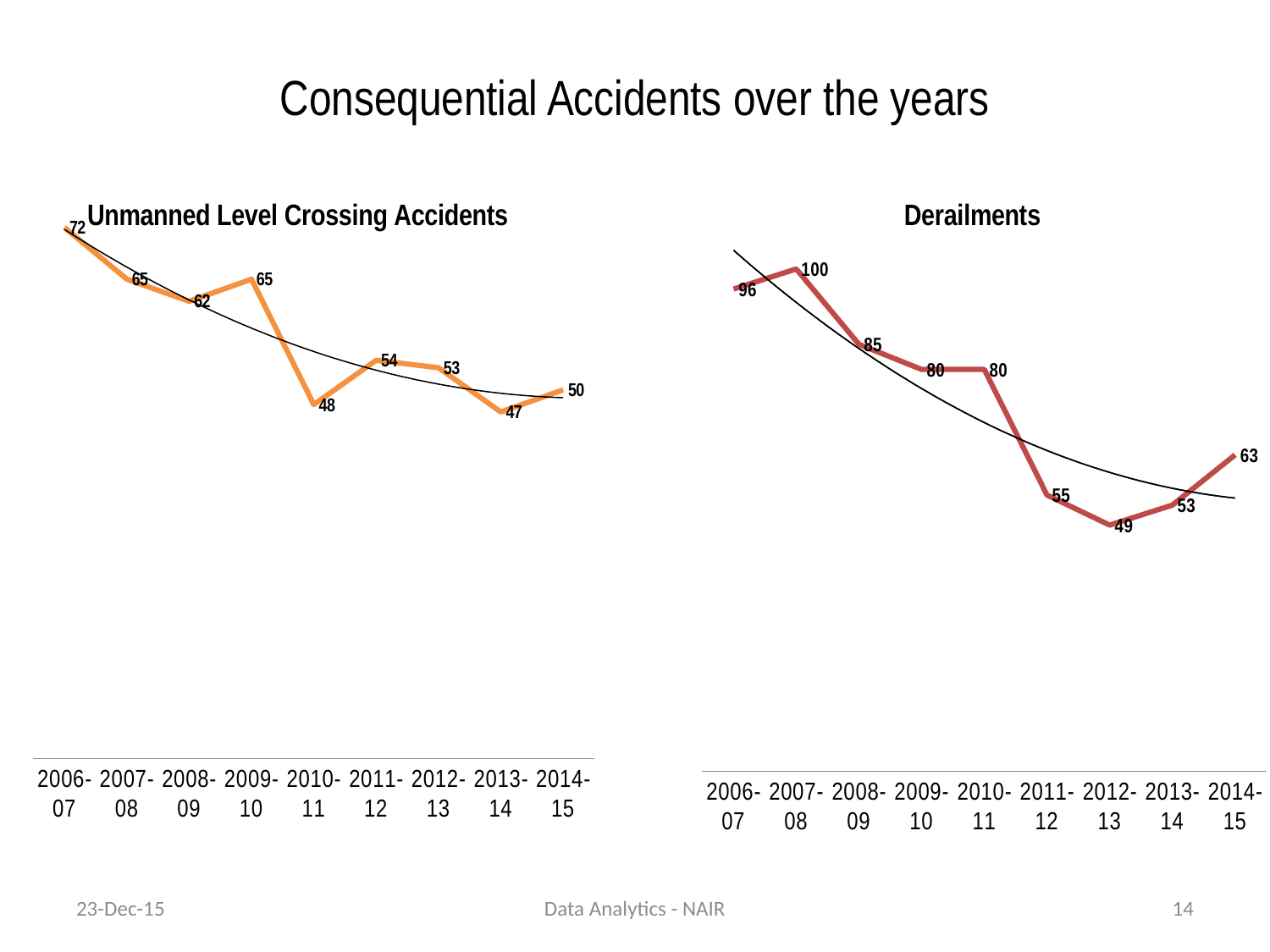
In the Unmanned Level Crossing Accidents chart, which is larger, the value for 2009-10 or the value for 2011-12? 2009-10 In the Unmanned Level Crossing Accidents chart, what is the value for 2010-11? 48 In the Derailments chart, which year has the lowest value? 2012-13 What type of chart is the Unmanned Level Crossing Accidents chart? Line chart In the Derailments chart, what is the difference between the values for 2006-07 and 2014-15? 33 What is the title of the slide? Consequential Accidents over the years In the Unmanned Level Crossing Accidents chart, what is the difference between the values for 2006-07 and 2013-14? 25 In the Unmanned Level Crossing Accidents chart, which year has the highest value? 2006-07 In the Derailments chart, what is the value for 2007-08? 100 In the Derailments chart, what is the value for 2013-14? 53 How many data points are plotted in the Derailments chart? 9 In the Derailments chart, do the values generally rise or fall from 2006-07 to 2014-15? Fall